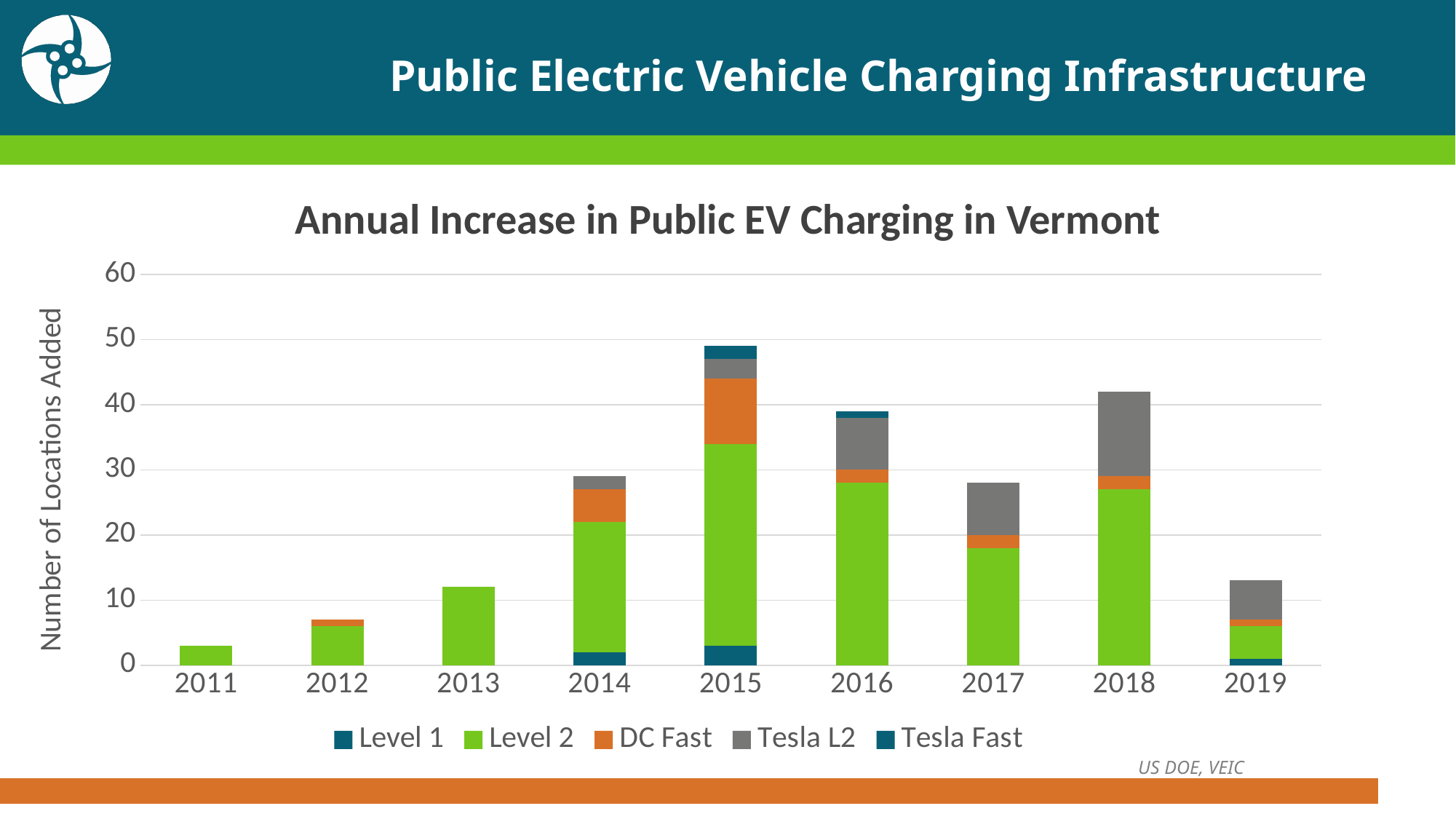
How many series does the chart's legend list? 5 What is the label on the chart's y axis? Number of Locations Added Is the total number of locations added in 2015 greater or less than 40? greater Is the total number of locations added in 2016 greater or less than 30? greater How many years are shown on the x axis of the chart? 9 Which year has the highest total number of locations added? 2015 Which year had a larger total of locations added, 2016 or 2017? 2016 Do the total locations added rise or fall from 2011 to 2015? rise Which year has the lowest total number of locations added? 2011 Is the total number of locations added in 2011 greater or less than 10? less Which year had a larger total of locations added, 2015 or 2018? 2015 What kind of chart is shown on the slide? Stacked bar chart